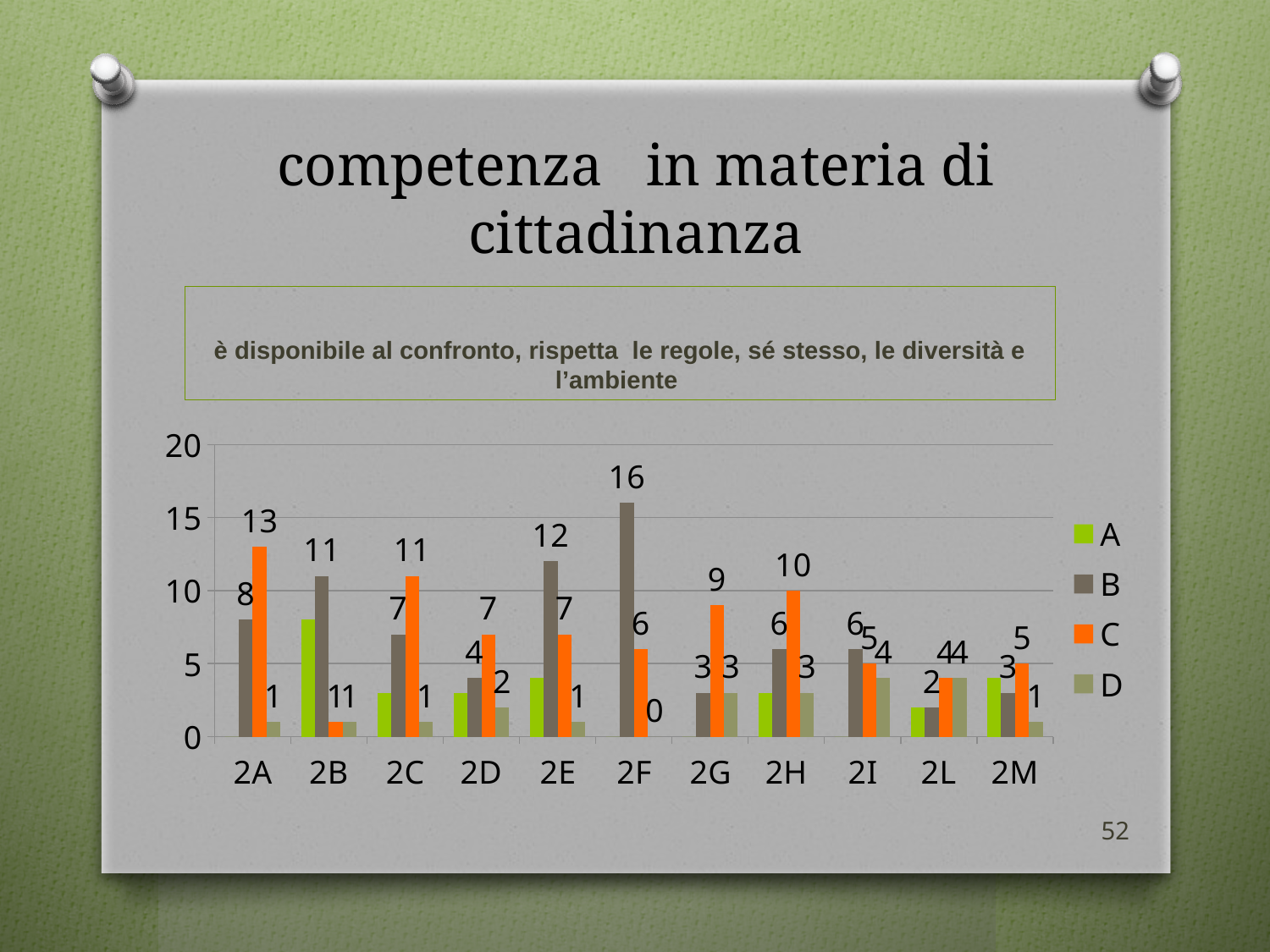
How many series does the legend list? 4 What is the value of series B for class 2F? 16 What is the value of series C for class 2H? 10 What is the value of series C for class 2A? 13 Which class has the highest value for series B? 2F Is the value of series B for class 2F greater or less than 15? greater What kind of chart is shown on the slide? bar chart What are the entries listed in the legend? A, B, C, D Which class has the highest value for series C? 2A How many classes are shown along the x axis? 11 For class 2E, which is larger: series B or series C? B What is the difference between series C and series B for class 2A? 5